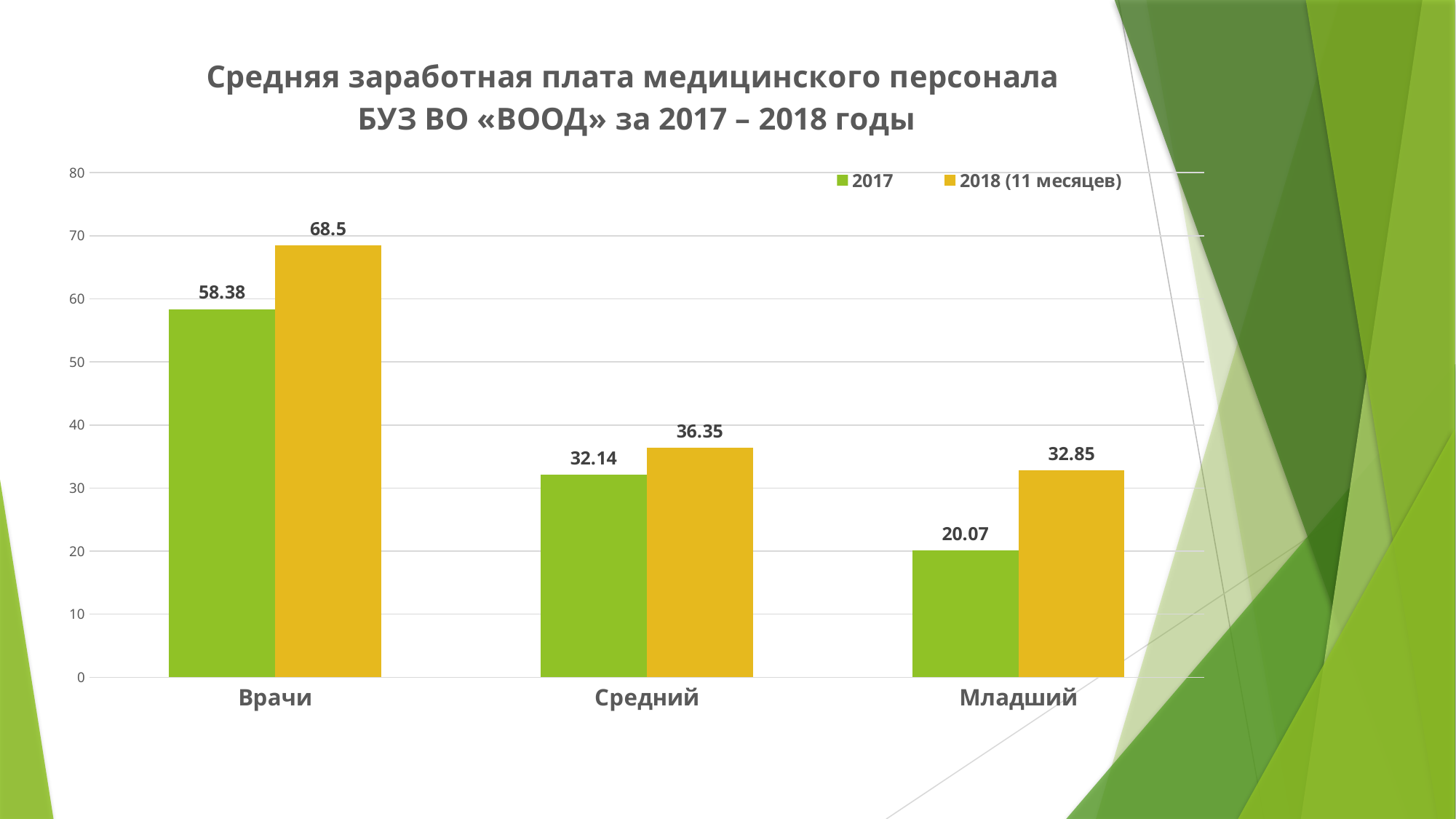
Which category has the lowest value in the 2017 series? Младший What is the value for Младший in the 2018 (11 месяцев) series? 32.85 What kind of chart is shown on the slide? Bar chart How many categories are shown on the x axis? 3 What is the difference between the 2018 (11 месяцев) and 2017 values for Врачи? 10.12 What is the value for Врачи in the 2017 series? 58.38 Which colour represents the 2017 series? Green Which category has the highest value in the 2018 (11 месяцев) series? Врачи How many series does the legend list? 2 Which is larger: the 2017 value for Средний or the 2018 (11 месяцев) value for Младший? 2018 (11 месяцев) value for Младший What is the difference between the 2018 (11 месяцев) and 2017 values for Младший? 12.78 What is the value for Средний in the 2018 (11 месяцев) series? 36.35